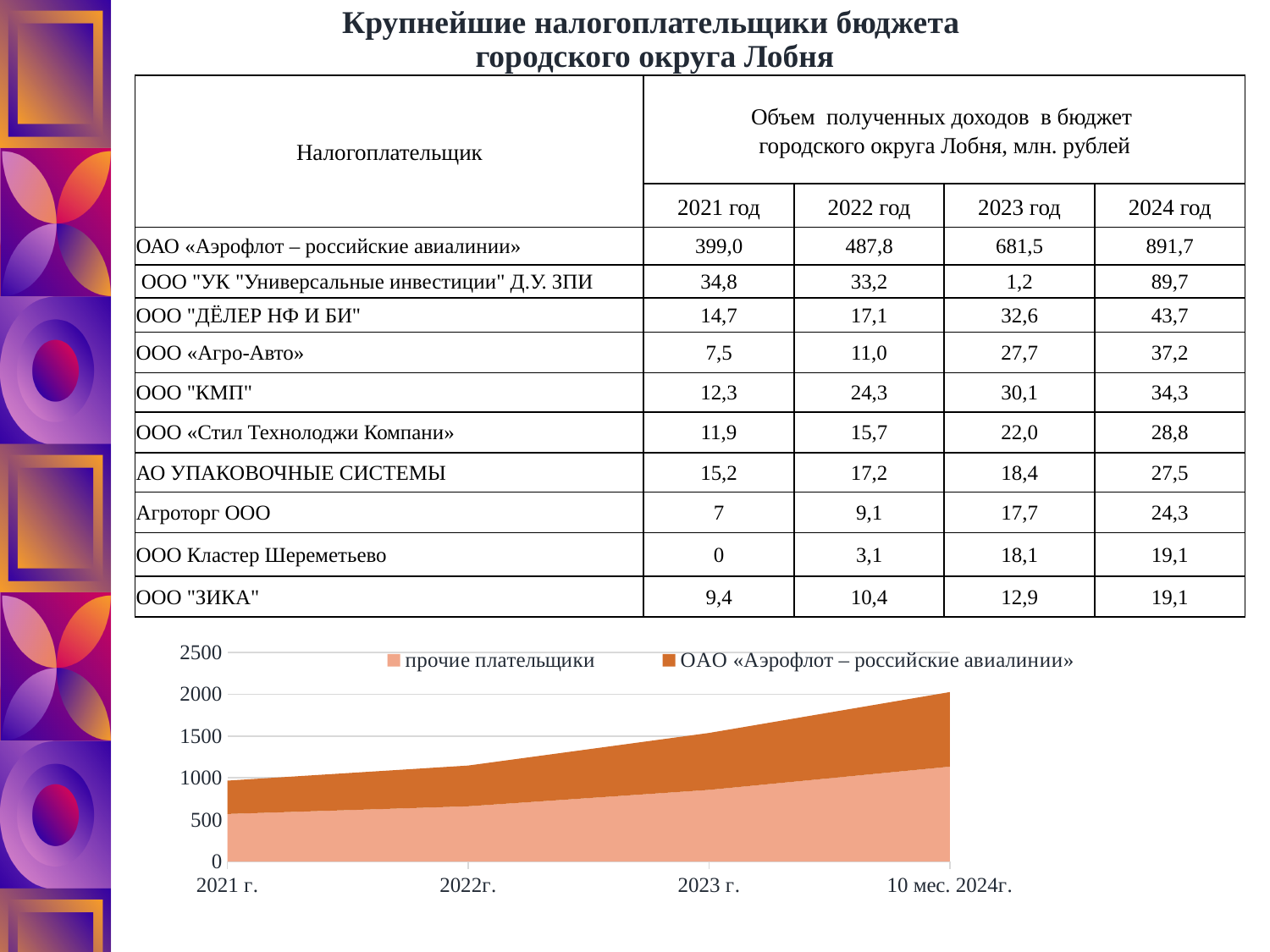
Is the stacked total in 10 мес. 2024г. greater or less than 1500? greater Is the value for прочие плательщики in 2021 г. greater or less than 500? greater What kind of chart is shown at the bottom of the slide? Stacked area chart How many series does the legend of the area chart list? 2 Is the value for прочие плательщики in 10 мес. 2024г. greater or less than 1000? greater What is the label of the last point on the x axis of the area chart? 10 мес. 2024г. How many points along the x axis does the area chart have? 4 In 10 мес. 2024г., which series has the larger value: прочие плательщики or ОАО «Аэрофлот – российские авиалинии»? прочие плательщики Which series is shown in dark orange in the area chart? ОАО «Аэрофлот – российские авиалинии» Does the total of the stacked areas rise or fall from 2021 г. to 10 мес. 2024г.? Rise